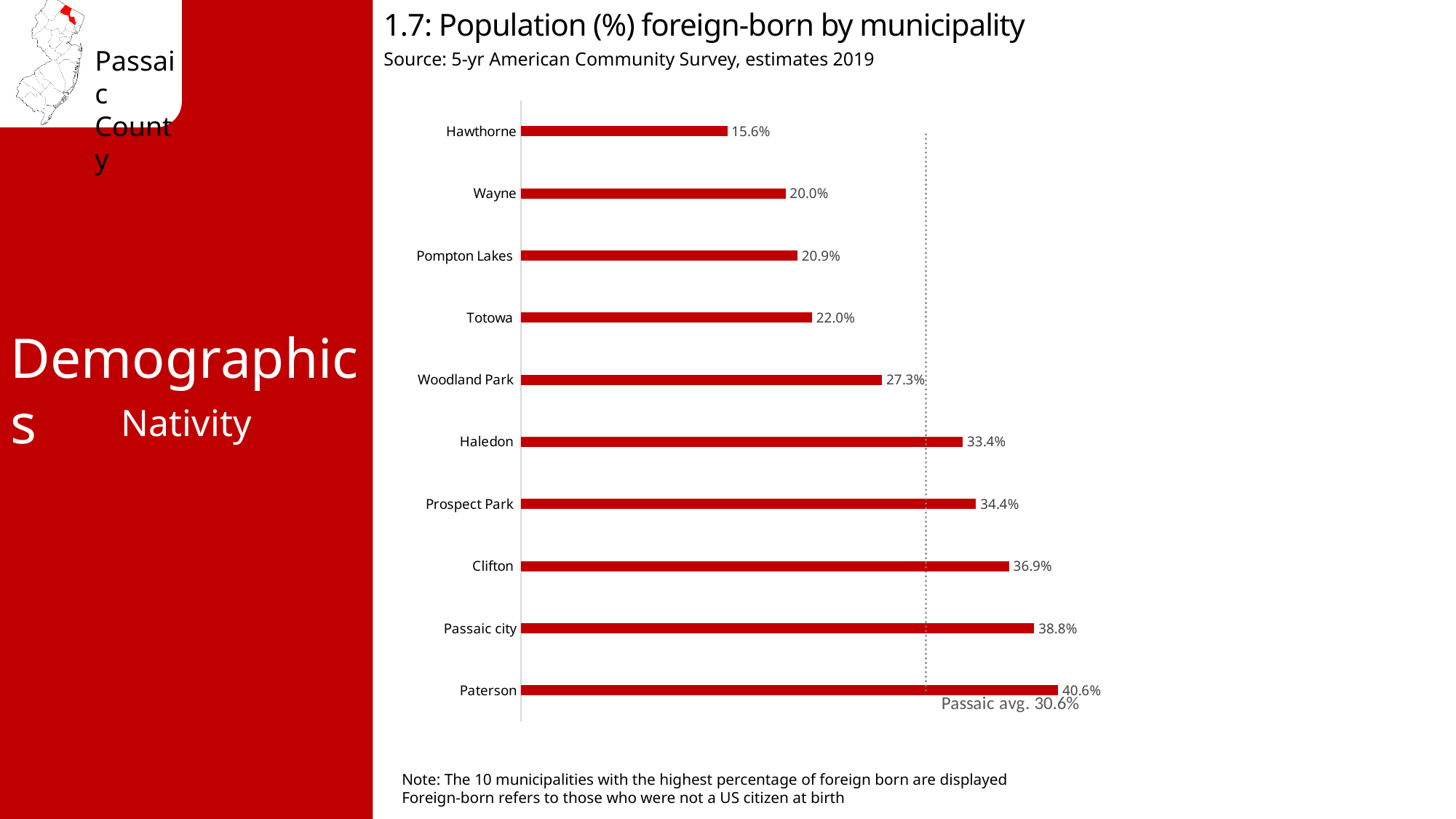
Which has a higher foreign-born percentage, Totowa or Pompton Lakes? Totowa What type of chart is used to show the foreign-born population by municipality? Bar chart What is the source of the data in the chart? 5-yr American Community Survey, estimates 2019 How many municipalities are shown in the chart? 10 What is the difference in foreign-born percentage between Haledon and Wayne? 13.4% What is the foreign-born population percentage for Clifton? 36.9% What is the foreign-born population percentage for Woodland Park? 27.3% Which municipality has the lowest percentage of foreign-born population? Hawthorne What is the difference in foreign-born percentage between Paterson and Passaic city? 1.8% What is the foreign-born population percentage for Hawthorne? 15.6% What is the Passaic average foreign-born percentage marked by the dotted line? 30.6% Which municipality has the highest percentage of foreign-born population? Paterson